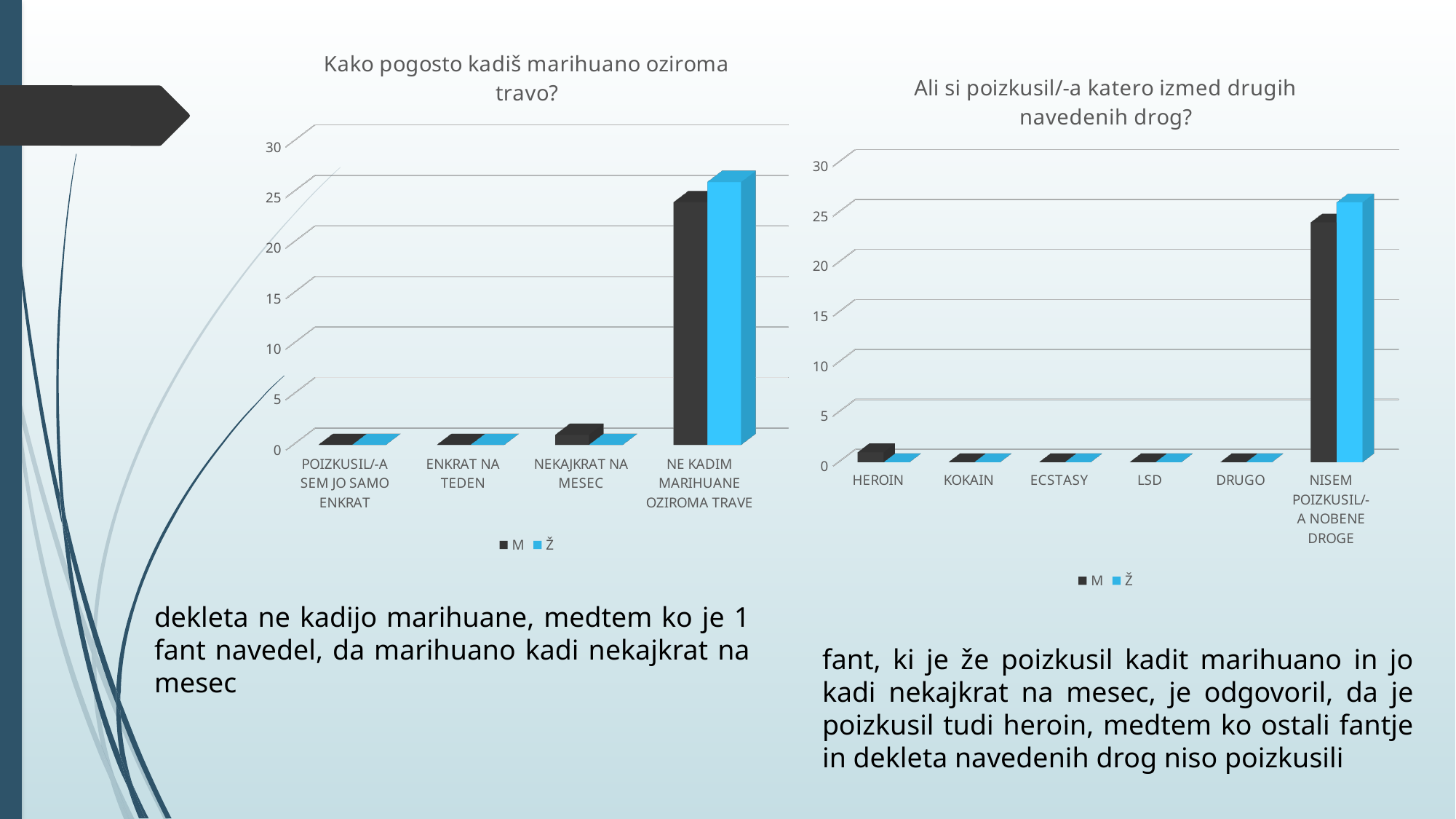
In the left chart "Kako pogosto kadiš marihuano oziroma travo?", is the value of M for NEKAJKRAT NA MESEC greater or less than 5? less In the right chart "Ali si poizkusil/-a katero izmed drugih navedenih drog?", what colour represents the series Ž? light blue What type of chart is the left chart titled "Kako pogosto kadiš marihuano oziroma travo?"? bar chart In the left chart "Kako pogosto kadiš marihuano oziroma travo?", how many categories are shown on the x axis? 4 In the left chart "Kako pogosto kadiš marihuano oziroma travo?", how many series does the legend list? 2 In the right chart "Ali si poizkusil/-a katero izmed drugih navedenih drog?", is the value of M for NISEM POIZKUSIL/-A NOBENE DROGE greater or less than 20? greater In the left chart "Kako pogosto kadiš marihuano oziroma travo?", which is larger for series M: NE KADIM MARIHUANE OZIROMA TRAVE or NEKAJKRAT NA MESEC? NE KADIM MARIHUANE OZIROMA TRAVE In the left chart "Kako pogosto kadiš marihuano oziroma travo?", which category has the highest value for series M? NE KADIM MARIHUANE OZIROMA TRAVE In the right chart "Ali si poizkusil/-a katero izmed drugih navedenih drog?", is the value of M for HEROIN greater or less than 5? less In the right chart "Ali si poizkusil/-a katero izmed drugih navedenih drog?", which category has the highest value for series Ž? NISEM POIZKUSIL/-A NOBENE DROGE In the right chart "Ali si poizkusil/-a katero izmed drugih navedenih drog?", how many categories are shown on the x axis? 6